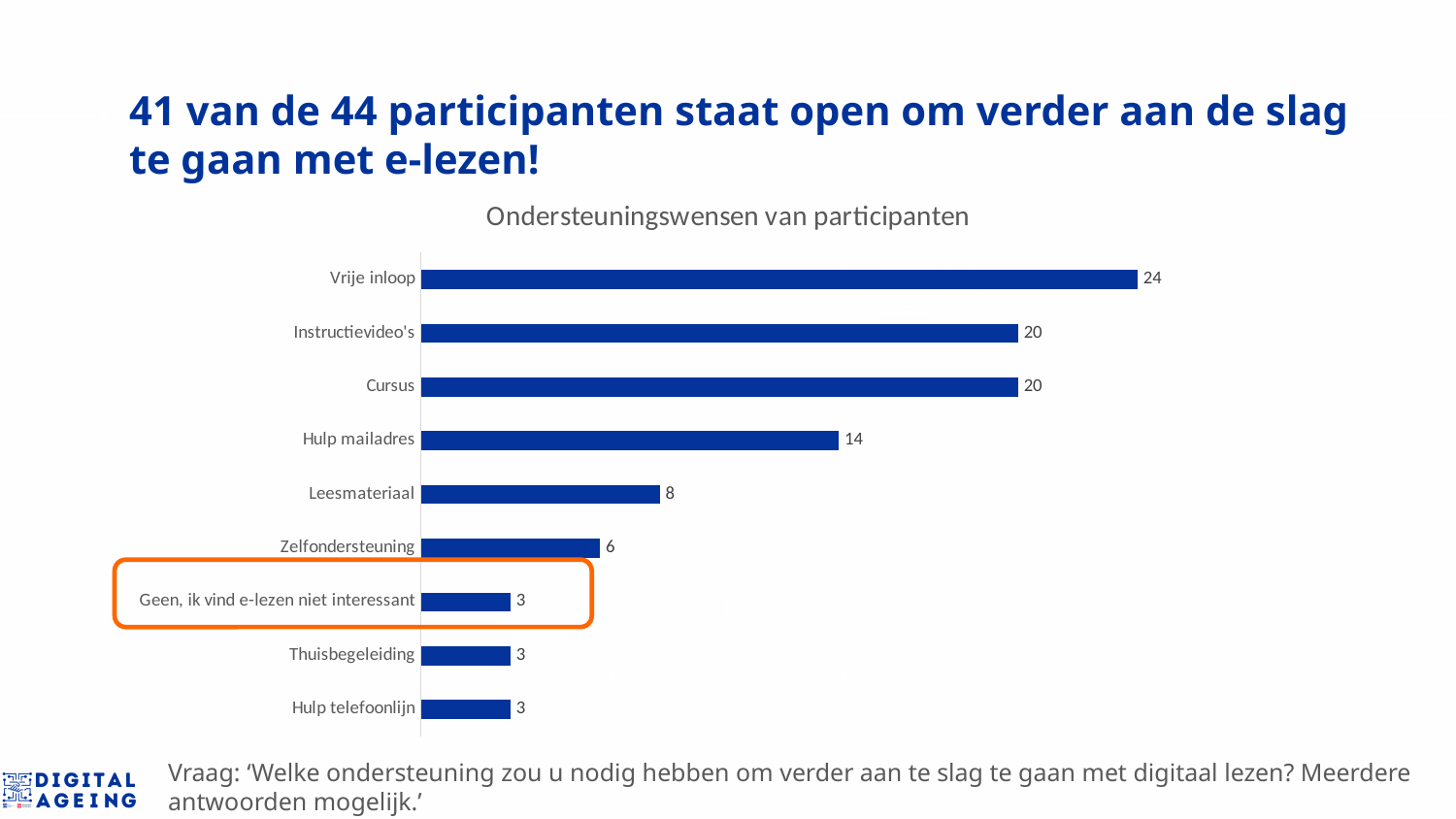
What is the value for Zelfondersteuning? 6 How many categories are shown in the chart? 9 What is the difference between the values for Hulp mailadres and Leesmateriaal? 6 What is the title of the chart? Ondersteuningswensen van participanten What is the value for Vrije inloop? 24 What is the value for Leesmateriaal? 8 What is the value for Hulp mailadres? 14 Which category has the highest value? Vrije inloop What kind of chart is shown on the slide? Bar chart Which category is highlighted with an orange box? Geen, ik vind e-lezen niet interessant What is the difference between the values for Vrije inloop and Cursus? 4 Which is larger, the value for Instructievideo's or the value for Zelfondersteuning? Instructievideo's